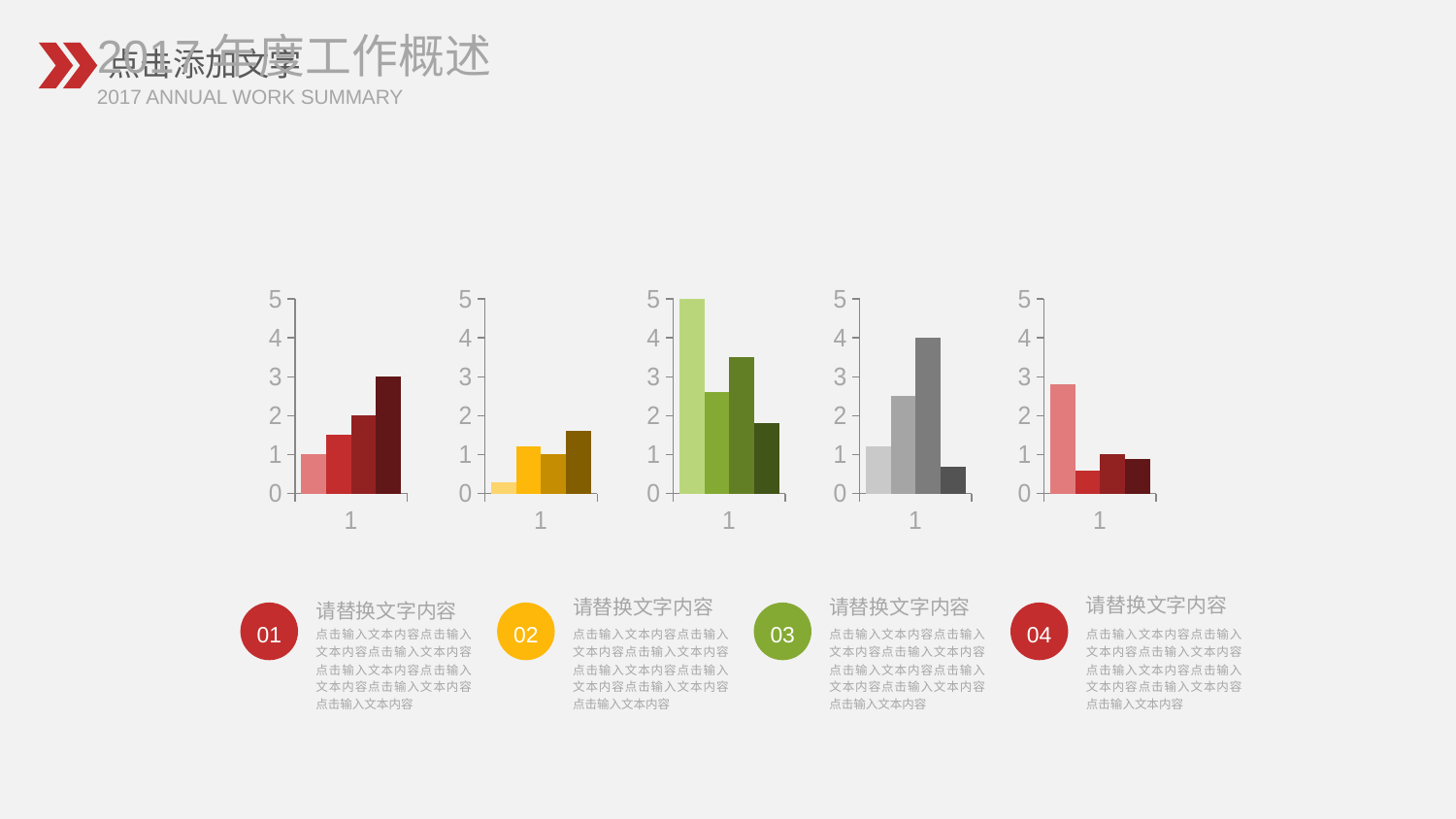
How many bar charts are shown on the slide? 5 In the second (yellow) chart, is the value of the first (leftmost) bar greater or less than 1? less In the middle (green) chart, which is larger: the second bar or the third bar? the third bar In the fourth (gray) chart, what value does the tallest bar reach? 4 What kind of chart is the leftmost chart on the slide? bar chart In the leftmost (red) chart, what value does the tallest (rightmost) bar reach? 3 What is the highest value shown on the vertical axis of each chart? 5 In the leftmost (red) chart, is the value of the second bar greater or less than 2? less In the middle (green) chart, how many bars are plotted? 4 In the rightmost (pink/red) chart, is the value of the first (leftmost) bar greater or less than 2? greater In the middle (green) chart, what value does the tallest (leftmost) bar reach? 5 In the fourth (gray) chart, which bar is the lowest: the first, second, third or fourth? the fourth